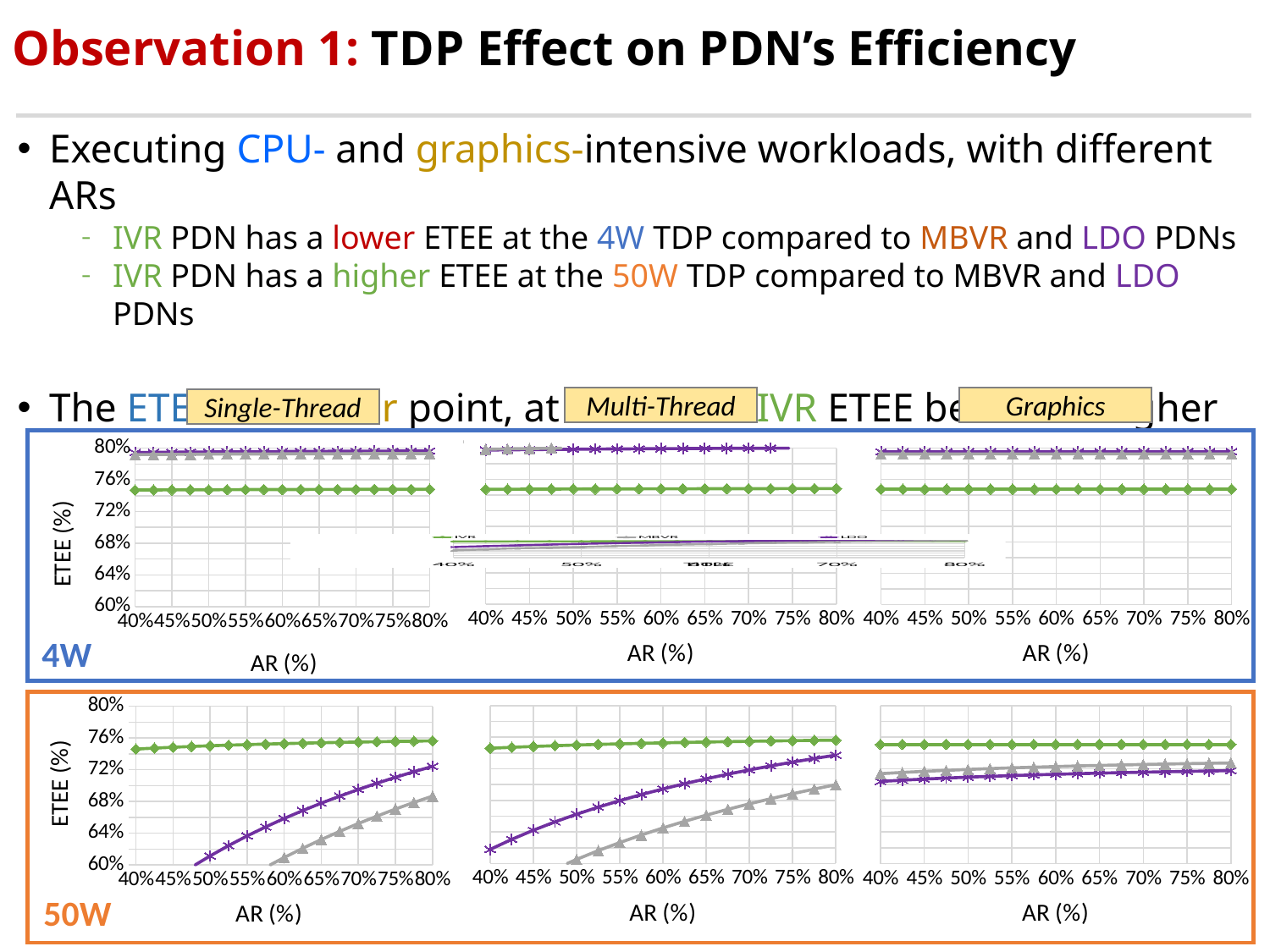
In the 4W Graphics chart, which series has the lowest line, IVR or LDO? IVR What kind of chart is the 4W Single-Thread chart? line chart What is the y-axis label of the 4W charts? ETEE (%) In the 4W Single-Thread chart, is the IVR value at 40% AR greater or less than 72%? greater In the 50W Single-Thread chart, is the MBVR value at 80% AR greater or less than 72%? less In the 50W Single-Thread chart, does the LDO line rise or fall as AR increases? rises How many AR tick values are shown on the x axis of the 50W Multi-Thread chart? 9 In the 50W Graphics chart, is the IVR value at 80% AR greater or less than 72%? greater In the 50W Single-Thread chart, which series has the lowest value at 80% AR? MBVR In the 50W Multi-Thread chart, which is higher at 80% AR, IVR or MBVR? IVR How many series does the legend list for the charts? 3